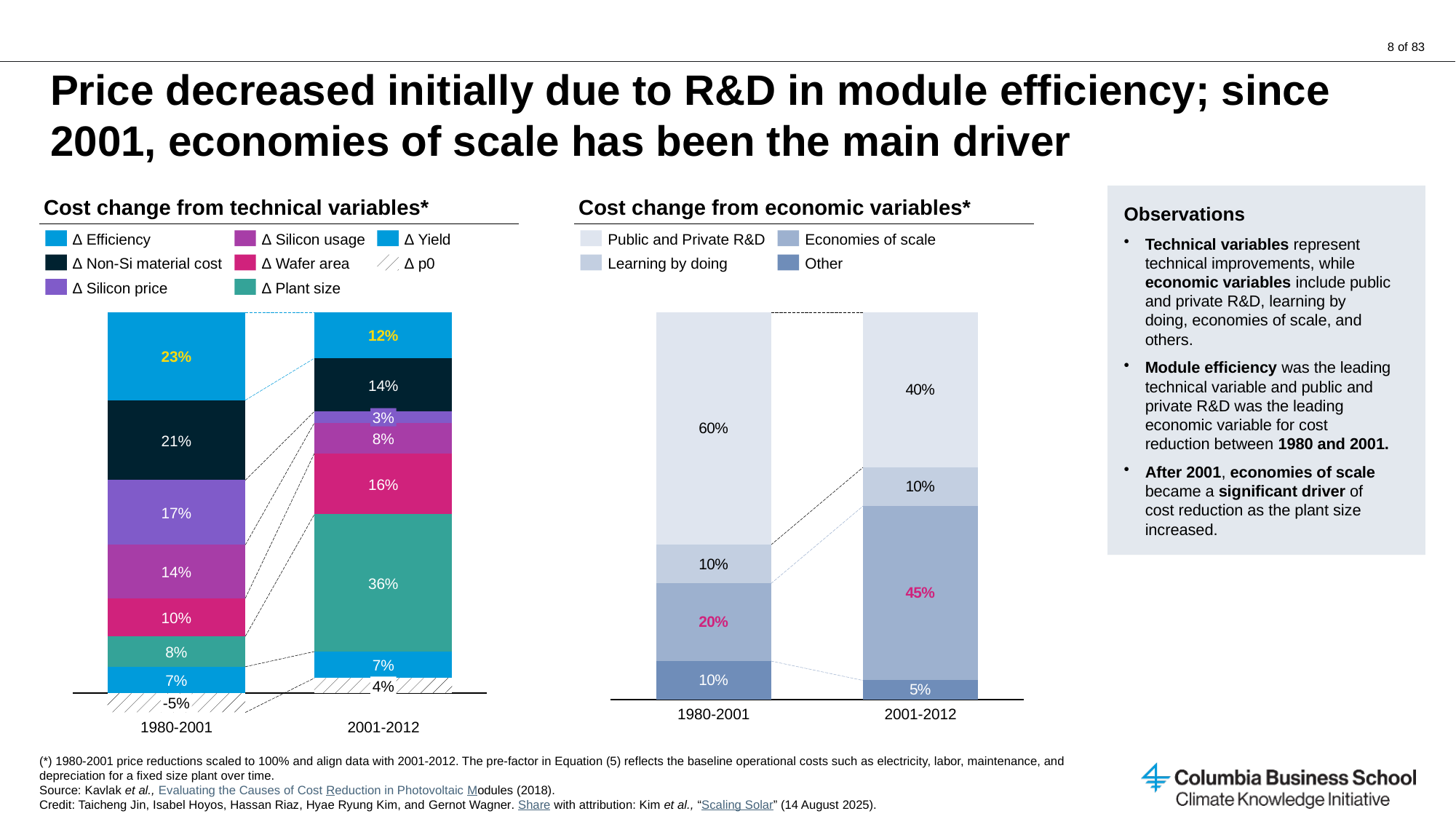
In the 'Cost change from technical variables*' chart, what is the value for Δ Wafer area in 1980-2001? 10% How many series does the legend of the 'Cost change from technical variables*' chart list? 8 What kind of chart is the 'Cost change from economic variables*' chart? Stacked bar chart In the 'Cost change from economic variables*' chart, what is the value for Other in 2001-2012? 5% In the 'Cost change from economic variables*' chart, what is the value for Public and Private R&D in 1980-2001? 60% In the 'Cost change from economic variables*' chart, what is the value for Economies of scale in 2001-2012? 45% In the 'Cost change from technical variables*' chart, which variable has the largest segment in the 2001-2012 bar? Δ Plant size In the 'Cost change from economic variables*' chart, by how many percentage points did Economies of scale increase from 1980-2001 to 2001-2012? 25 percentage points In the 'Cost change from economic variables*' chart, is Public and Private R&D larger in 1980-2001 or in 2001-2012? 1980-2001 In the 'Cost change from technical variables*' chart, what is the value for Δ Efficiency in 1980-2001? 23% How many series does the legend of the 'Cost change from economic variables*' chart list? 4 In the 'Cost change from technical variables*' chart, what is the value for Δ Plant size in 2001-2012? 36%